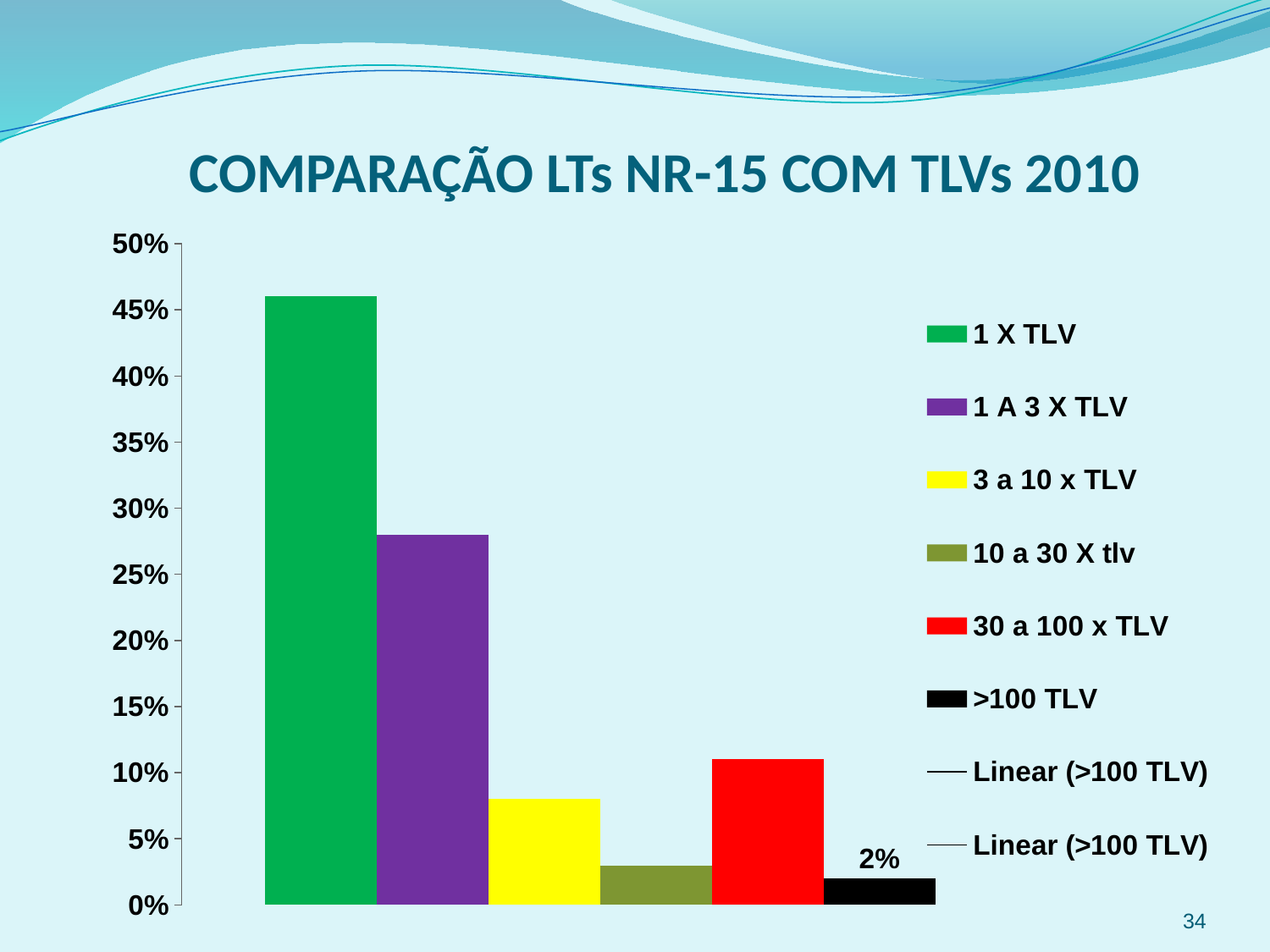
Which is larger, the bar for 1 X TLV or the bar for 1 A 3 X TLV? 1 X TLV Is the value for 10 a 30 X tlv greater or less than 5%? less Which is larger, the bar for 30 a 100 x TLV or the bar for 3 a 10 x TLV? 30 a 100 x TLV How many bars are plotted in the chart? 6 Is the value for 1 X TLV greater or less than 40%? greater Which category has the highest bar? 1 X TLV What type of chart is shown on the slide? Bar chart How many entries does the legend list? 8 Is the value for 1 A 3 X TLV greater or less than 25%? greater What is the value shown for the >100 TLV bar? 2%